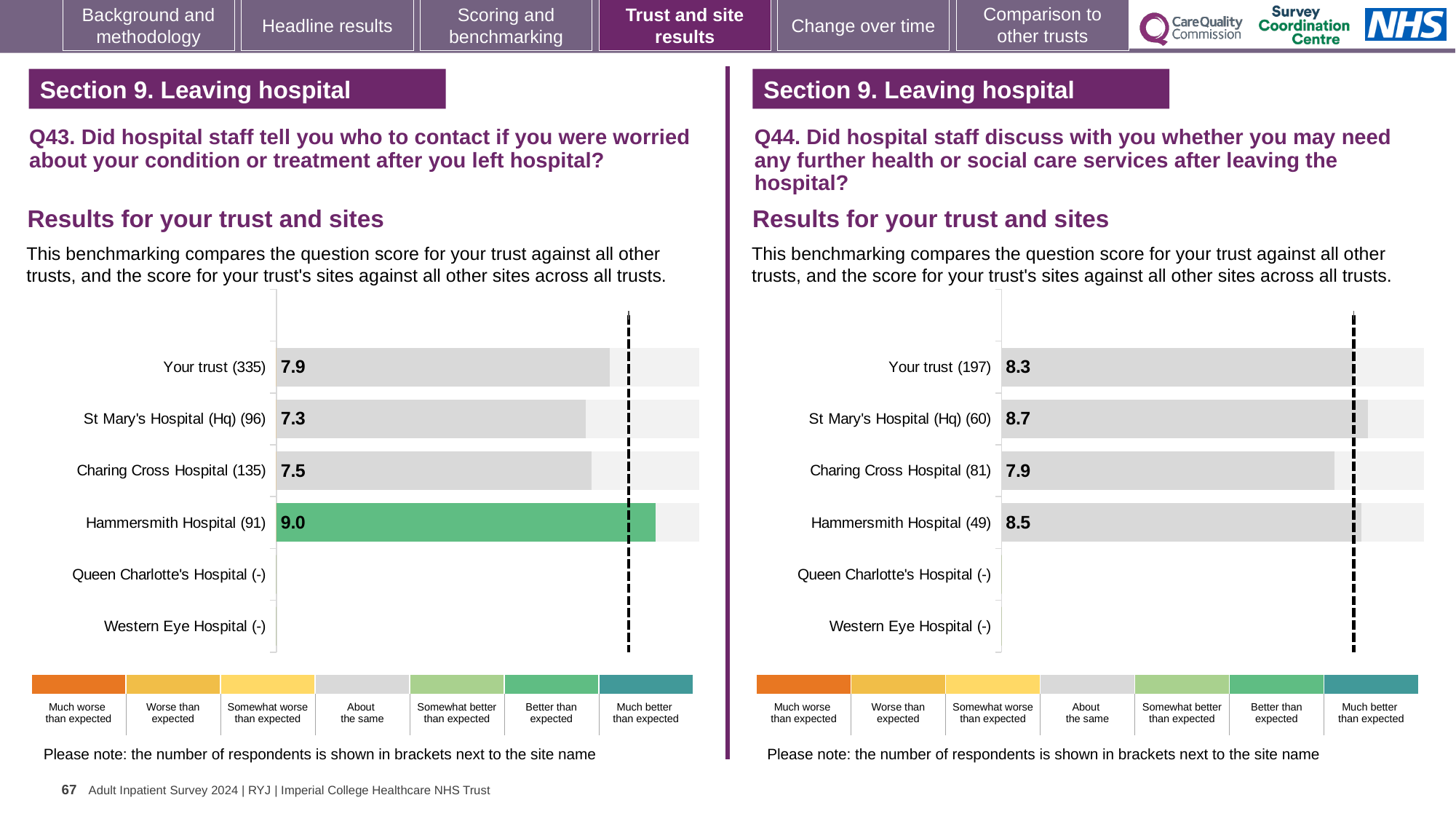
In the Q44 chart on the right, what is the score for Charing Cross Hospital (81)? 7.9 What kind of chart is used for the Q43 results on the left? Bar chart In the Q44 chart on the right, what is the score for St Mary's Hospital (Hq) (60)? 8.7 In the Q43 chart on the left, what is the score for Your trust (335)? 7.9 In the Q44 chart on the right, which site has the lowest score shown? Charing Cross Hospital (81) In the Q43 chart on the left, which site has the highest score? Hammersmith Hospital (91) In the Q44 chart on the right, which has the higher score: Hammersmith Hospital (49) or Charing Cross Hospital (81)? Hammersmith Hospital (49) In the Q44 chart on the right, what is the difference between the scores for St Mary's Hospital (Hq) (60) and Your trust (197)? 0.4 In the Q43 chart on the left, which bar is coloured green rather than grey? Hammersmith Hospital (91) In the Q43 chart on the left, what is the difference between the scores for Hammersmith Hospital (91) and St Mary's Hospital (Hq) (96)? 1.7 In the Q43 chart on the left, which site has the lowest score shown? St Mary's Hospital (Hq) (96) In the Q43 chart on the left, what is the score for Hammersmith Hospital (91)? 9.0